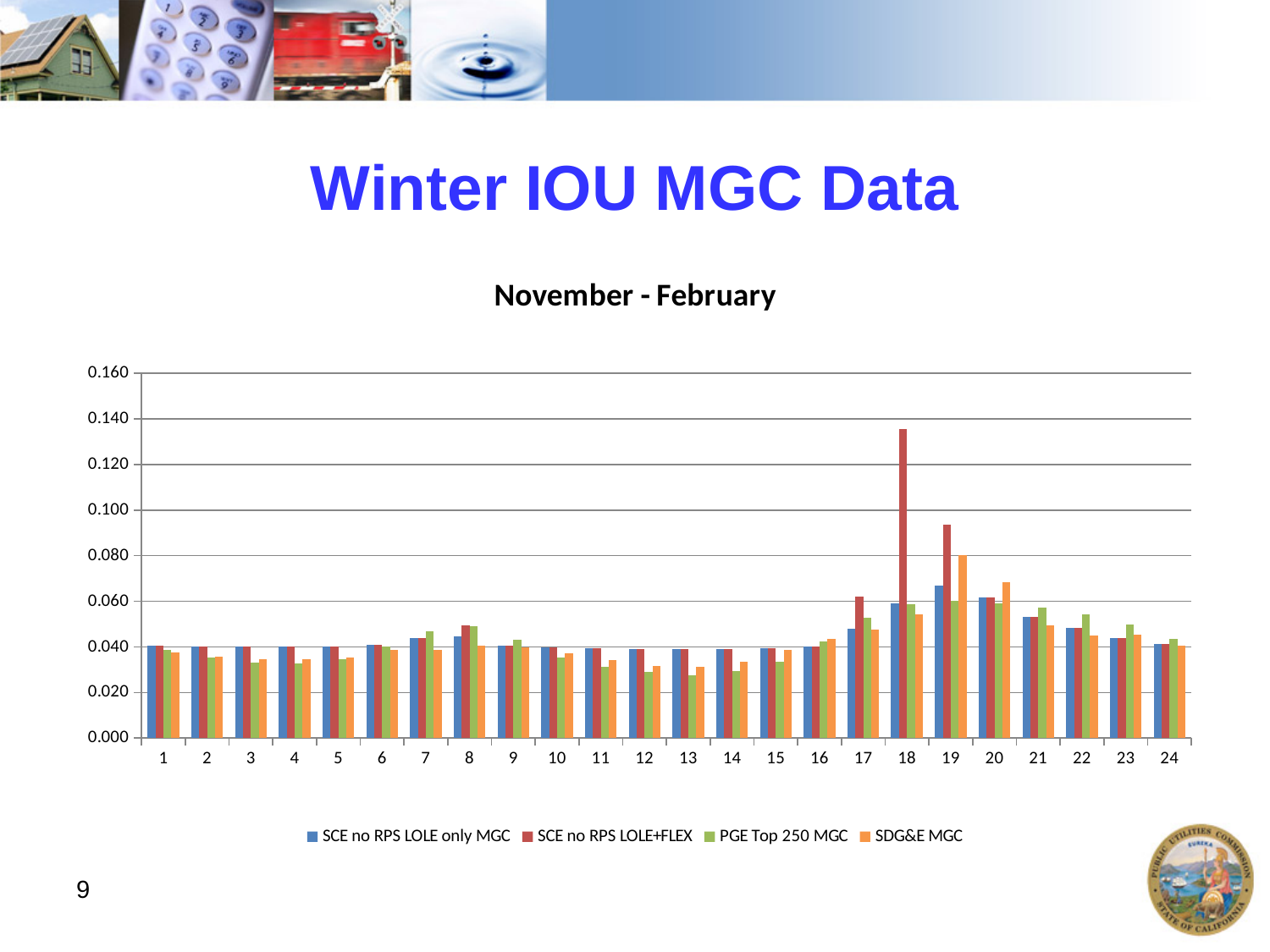
Is the value for PGE Top 250 MGC at category 13 greater or less than 0.040? less What kind of chart is shown on the slide? bar chart What is the title of the chart? November - February How many categories are shown along the x axis? 24 Is the value for SDG&E MGC at category 19 greater or less than 0.060? greater Is the value for SCE no RPS LOLE+FLEX at category 18 greater or less than 0.120? greater At category 18, which is larger: SCE no RPS LOLE+FLEX or SDG&E MGC? SCE no RPS LOLE+FLEX Which series is shown in orange in the legend? SDG&E MGC At which category does the SCE no RPS LOLE+FLEX series reach its highest value? 18 How many series does the legend list? 4 At category 19, which is larger: SCE no RPS LOLE+FLEX or PGE Top 250 MGC? SCE no RPS LOLE+FLEX